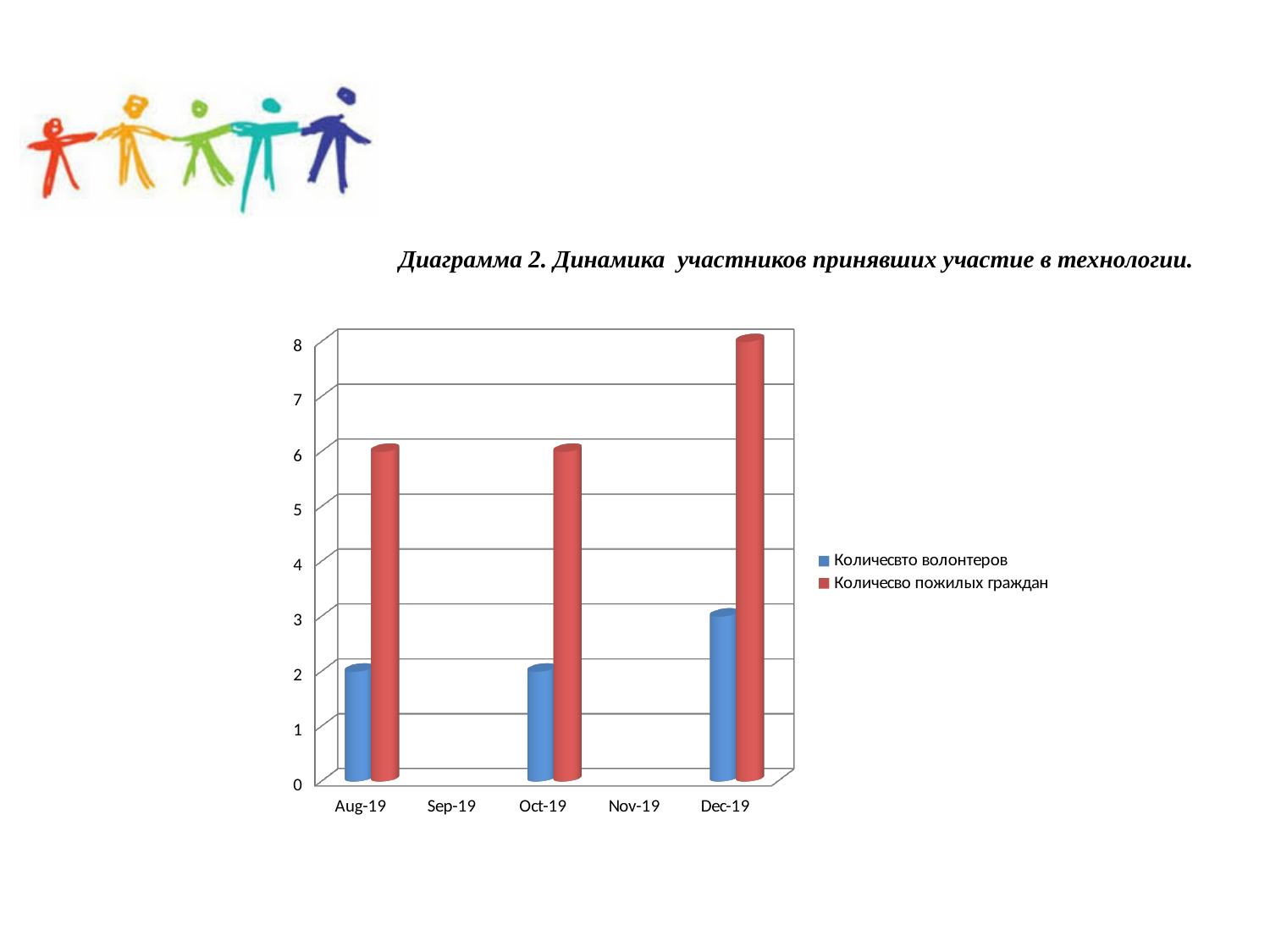
What is the value for Количесвто волонтеров in Aug-19? 2 What is the value for Количесвто волонтеров in Dec-19? 3 How many categories are labelled on the x axis? 5 Which is larger in Oct-19: Количесвто волонтеров or Количесво пожилых граждан? Количесво пожилых граждан What is the value for Количесво пожилых граждан in Aug-19? 6 Is the value for Количесво пожилых граждан in Oct-19 greater or less than 4? greater Which colour represents Количесвто волонтеров in the legend? blue What is the difference between Количесво пожилых граждан and Количесвто волонтеров in Dec-19? 5 In which month is the value for Количесво пожилых граждан highest? Dec-19 What kind of chart is shown on the slide? bar chart What is the value for Количесво пожилых граждан in Dec-19? 8 How many series does the legend list? 2